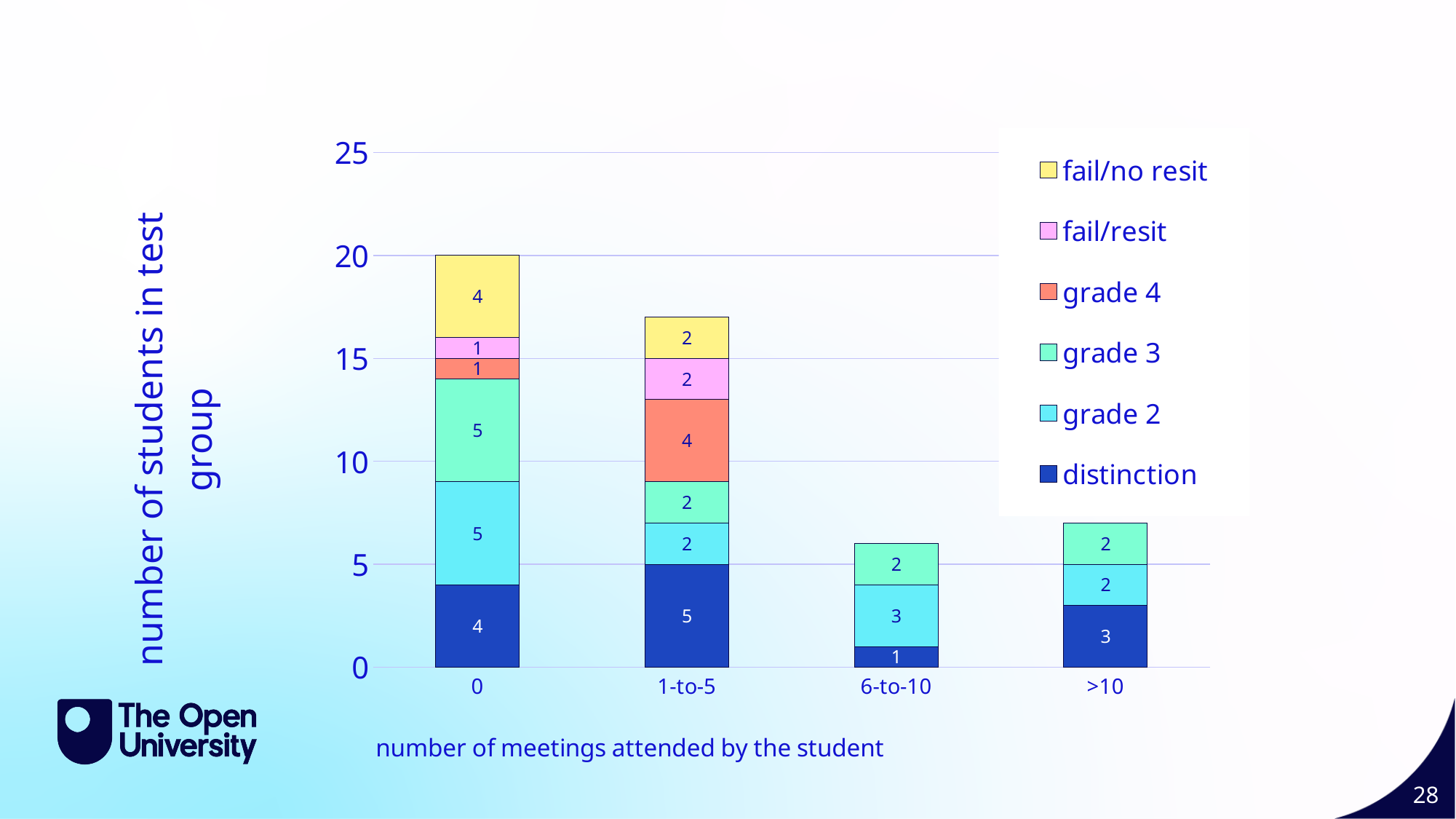
What is the value for grade 4 in the 1-to-5 category? 4 What is the label of the x axis? number of meetings attended by the student What is the total of the stacked bar for the 1-to-5 category? 17 Which category has the lowest total number of students? 6-to-10 How many categories are shown on the x axis? 4 What kind of chart is shown on the slide? stacked bar chart How many series does the legend list? 6 What is the difference between the grade 2 value for the 0 category and the grade 2 value for the 6-to-10 category? 2 Which category has the highest total number of students? 0 What is the total of the stacked bar for the 0 category? 20 What is the value for fail/no resit in the 0 category? 4 What is the value for distinction in the 1-to-5 category? 5